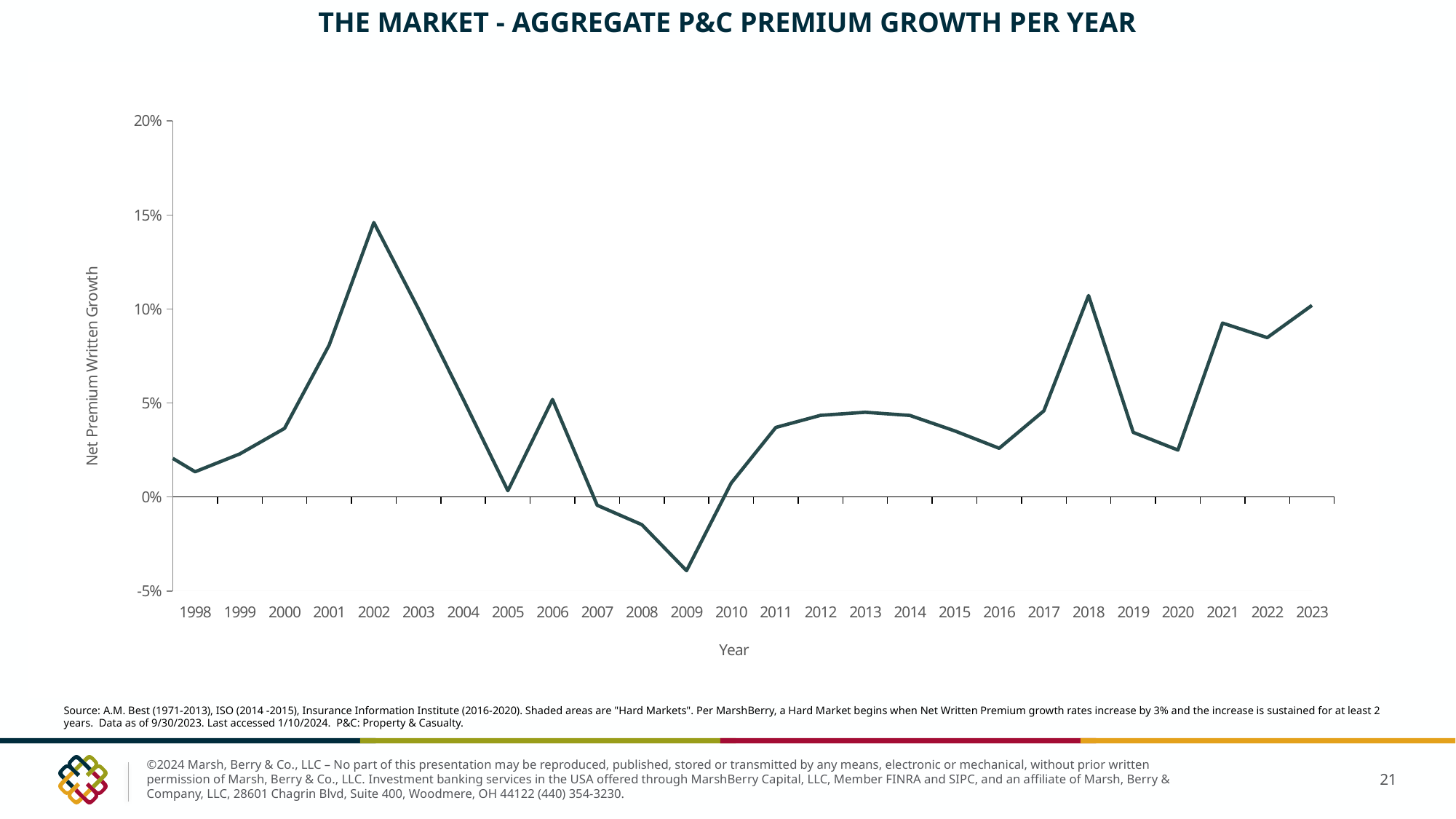
Is the value for 2005 greater or less than 5%? less Is the value for 2002 greater or less than 10%? greater Is the value for 2023 greater or less than 5%? greater How many years are plotted along the x axis? 26 What is the label of the y axis? Net Premium Written Growth Do the values rise or fall from 2002 to 2005? Fall Which year has the larger value, 2002 or 2018? 2002 What kind of chart is shown on the slide? Line chart Which year has the larger value, 2000 or 2001? 2001 Which year has the lowest net premium written growth? 2009 Which year has the highest net premium written growth? 2002